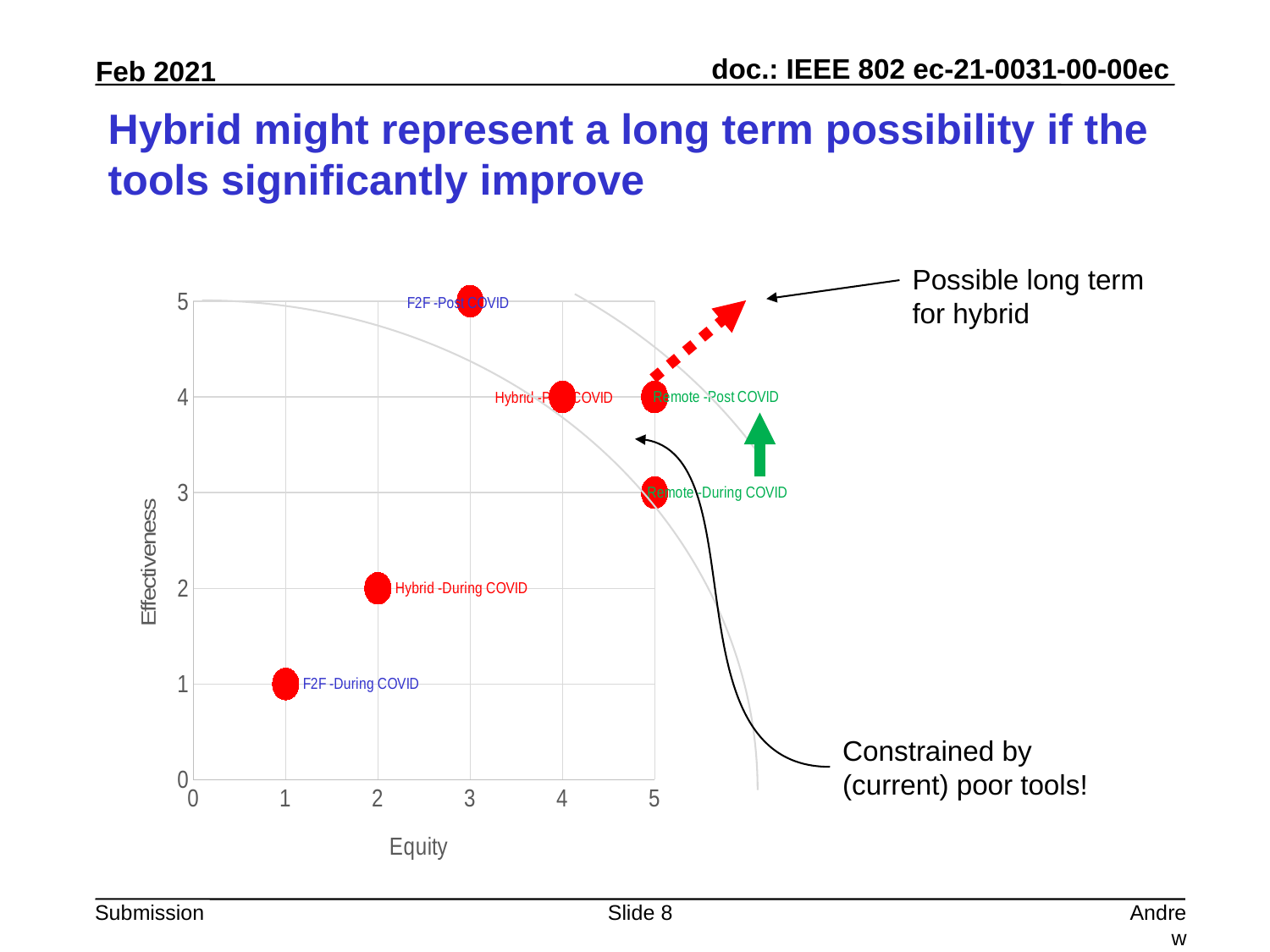
What is the difference in Effectiveness between Remote - Post COVID and Remote - During COVID? 1 What is the Effectiveness value for Remote - During COVID? 3 Which point has the highest Effectiveness value? F2F - Post COVID What is the Effectiveness value for F2F - During COVID? 1 What is the label of the horizontal axis of the chart? Equity Which has a higher Equity value, Hybrid - Post COVID or Remote - Post COVID? Remote - Post COVID How many data points are plotted on the chart? 6 What is the label of the vertical axis of the chart? Effectiveness What kind of chart is shown on the slide? scatter chart What is the Equity value for F2F - Post COVID? 3 Which point has the lowest Equity value? F2F - During COVID What is the Equity value for Hybrid - During COVID? 2